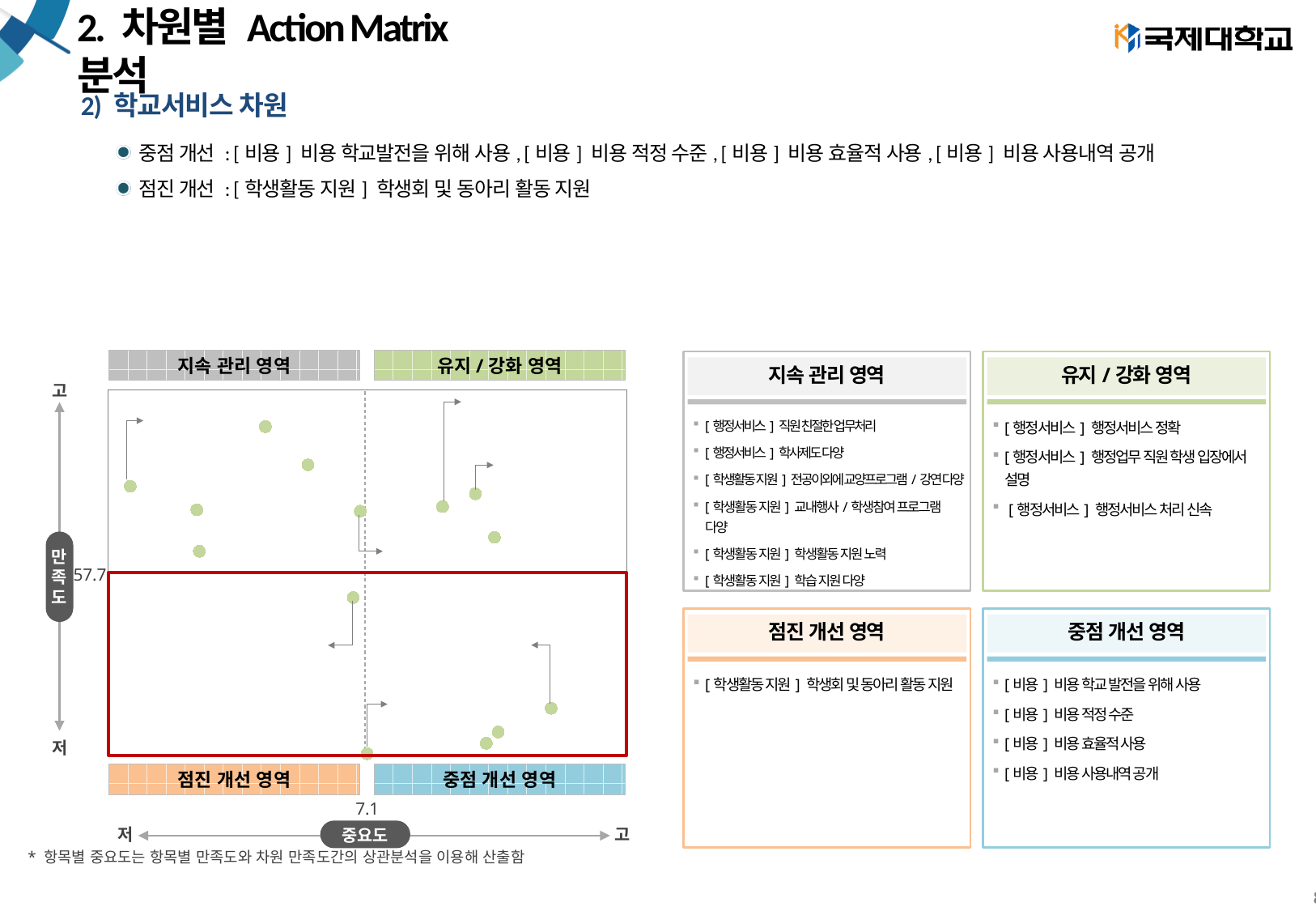
What value marks the dividing line on the vertical (만족도) axis of the action matrix? 57.7 How many items are listed in the 유지 / 강화 영역 box? 3 What kind of chart is shown on the left of the slide? scatter chart How many quadrant areas is the action matrix divided into? 4 How many items are listed in the 중점 개선 영역 box? 4 What is the label of the horizontal axis of the action matrix? 중요도 What value marks the dividing line on the horizontal (중요도) axis of the action matrix? 7.1 Which quadrant label appears at the bottom right of the action matrix? 중점 개선 영역